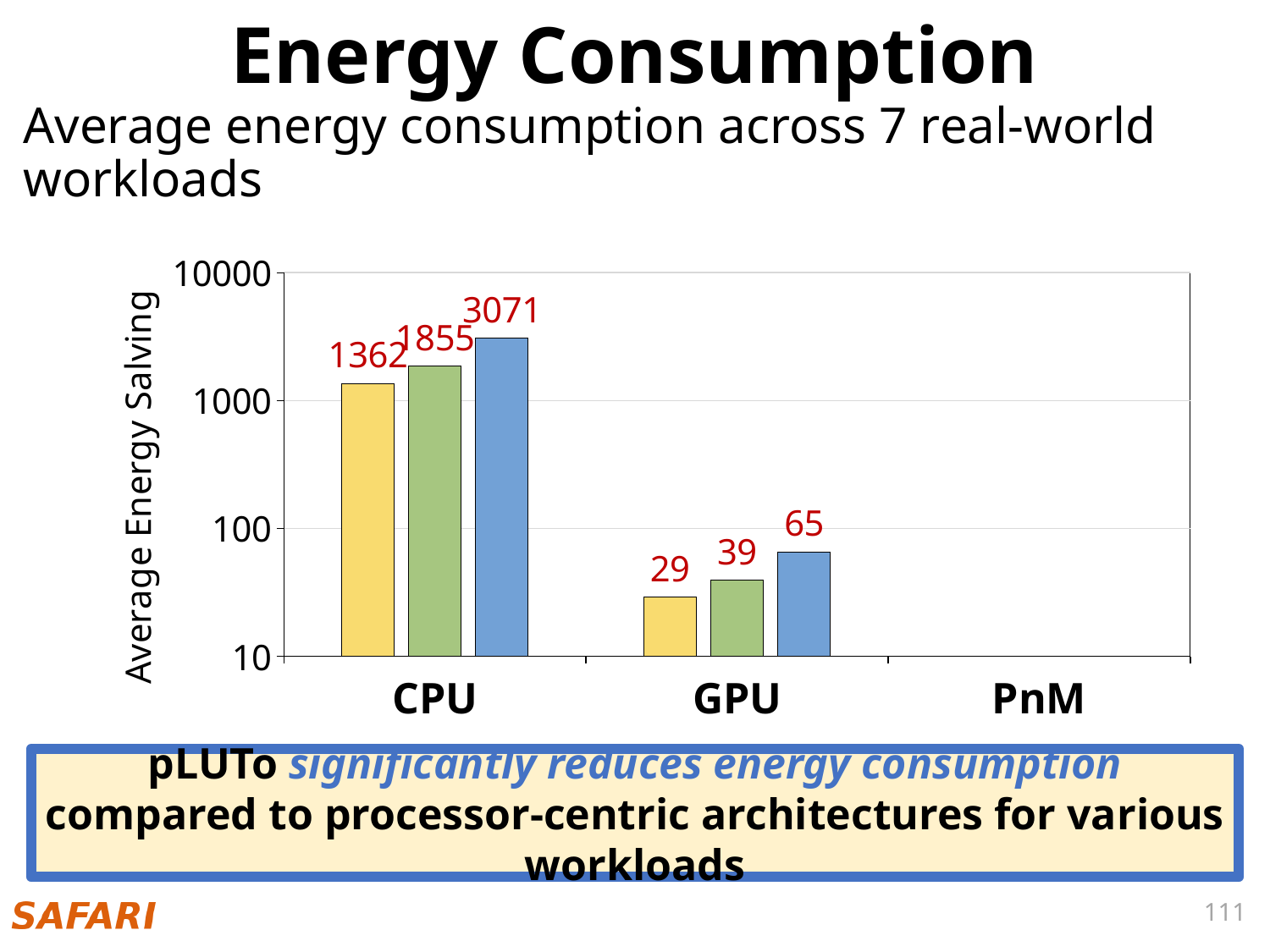
What is the label of the y axis? Average Energy Salving What is the value of the yellow bar for CPU? 1362 What is the value of the green bar for GPU? 39 Is the value of the yellow bar for GPU greater or less than 100? less Which category has the highest bar in the chart? CPU Which is larger, the blue bar for CPU or the blue bar for GPU? Blue bar for CPU What is the value of the green bar for CPU? 1855 How many categories are labelled on the x axis? 3 What is the value of the blue bar for GPU? 65 What kind of chart is shown on the slide? Bar chart What is the difference between the blue bar and the yellow bar for GPU? 36 What is the difference between the blue bar and the yellow bar for CPU? 1709